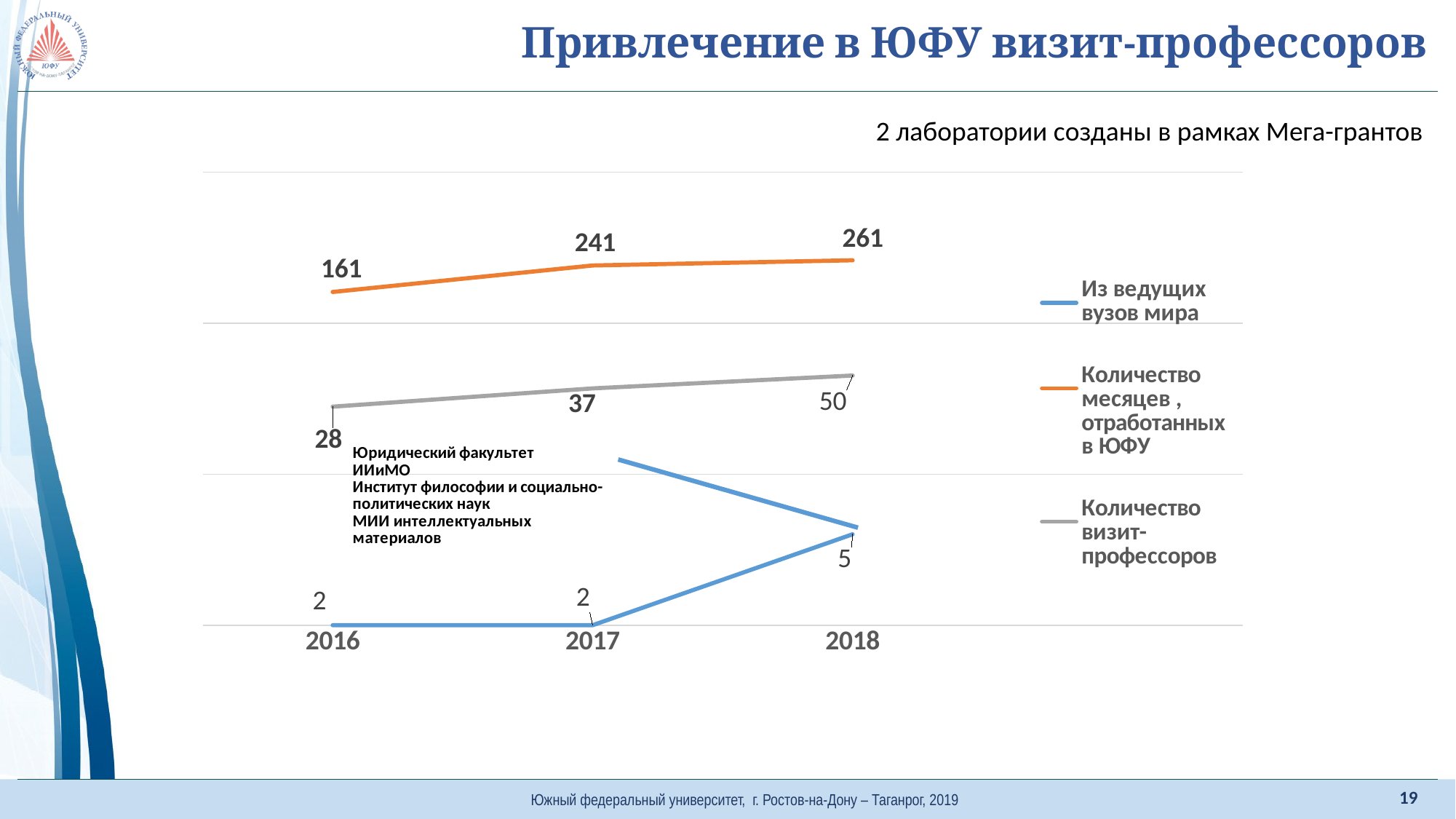
Which is larger: "Количество визит-профессоров" in 2017 or in 2018? 2018 In which year is "Количество месяцев, отработанных в ЮФУ" highest? 2018 What is the value of "Из ведущих вузов мира" in 2016? 2 Does "Количество визит-профессоров" rise or fall from 2016 to 2018? rise What is the value of "Количество месяцев, отработанных в ЮФУ" in 2017? 241 Which colour is used for the "Количество месяцев, отработанных в ЮФУ" series? orange What kind of chart is shown on the slide? line chart How many series does the legend list? 3 What is the difference between the 2018 and 2016 values of "Количество месяцев, отработанных в ЮФУ"? 100 What is the value of "Количество визит-профессоров" in 2018? 50 In which year is "Количество визит-профессоров" lowest? 2016 How many years are shown on the x axis? 3